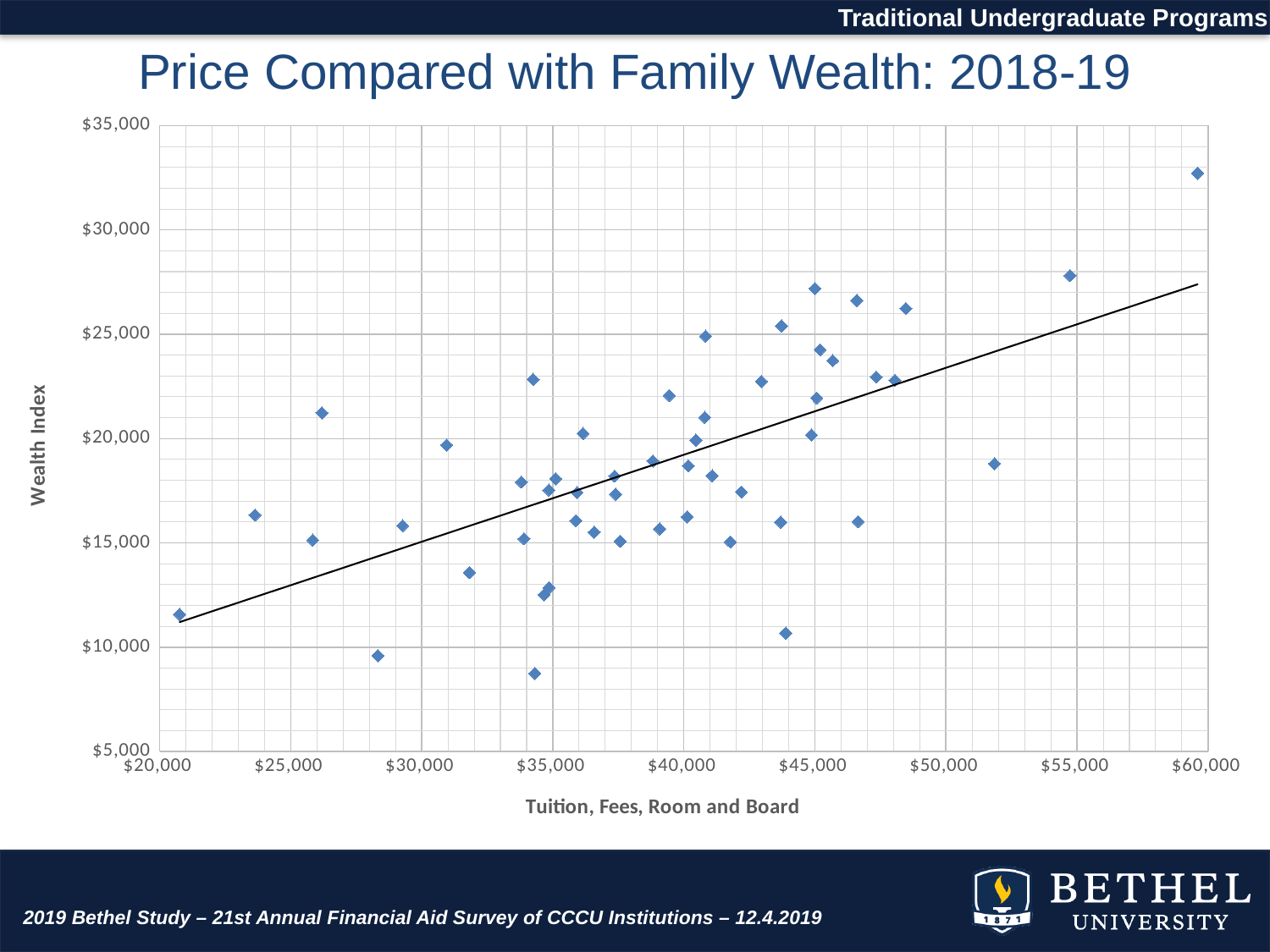
Is the Wealth Index of the lowest point on the chart greater or less than $10,000? less Does the point with the highest Wealth Index also have the highest Tuition, Fees, Room and Board? Yes Is the Wealth Index of the point plotted near $55,000 Tuition, Fees, Room and Board greater or less than $25,000? greater What kind of chart is shown on the slide? Scatter chart Is the Wealth Index of the point with the lowest Tuition, Fees, Room and Board greater or less than $15,000? less What are the x-axis and y-axis titles of the chart? Tuition, Fees, Room and Board (x axis) and Wealth Index (y axis) What is the title of the chart? Price Compared with Family Wealth: 2018-19 Does the trend line slope upward or downward from left to right? Upward Do the plotted points generally rise or fall as Tuition, Fees, Room and Board increases along the x axis? Rise